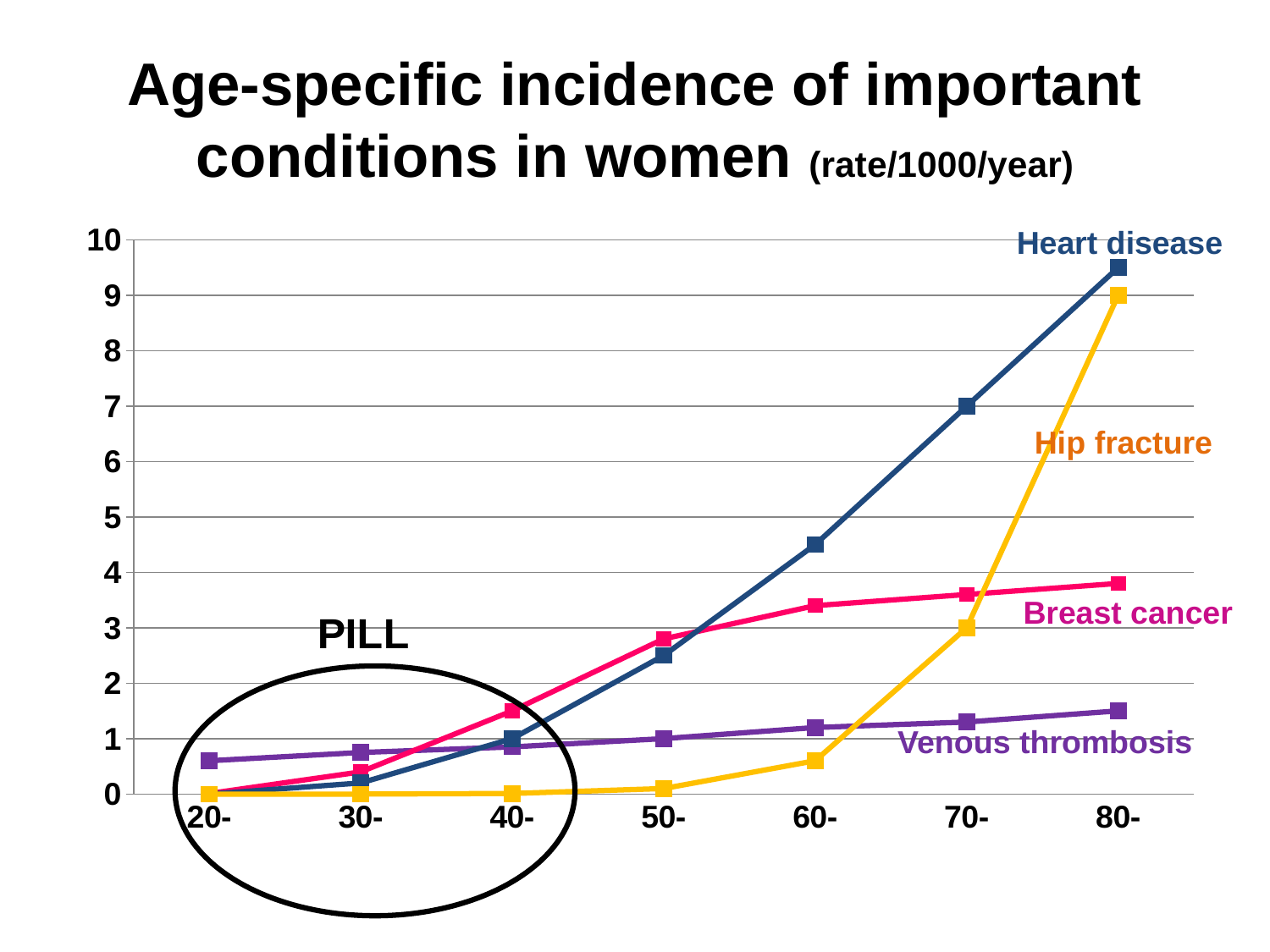
Which condition has the highest incidence at age 80-? Heart disease What kind of chart is shown on the slide? line chart Is the value for breast cancer at age 80- greater or less than 4? less What is the incidence of heart disease at age 70-? 7 What is the incidence of hip fracture at age 20-? 0 How many conditions (series) are plotted on the chart? 4 Which condition has the lowest incidence at age 80-? Venous thrombosis What is the incidence of hip fracture at age 80-? 9 Which is larger at age 50-: breast cancer or heart disease? Breast cancer Does the incidence of heart disease rise or fall with increasing age? rise How many age groups are shown along the x axis? 7 Is the value for heart disease at age 60- greater or less than 4? greater